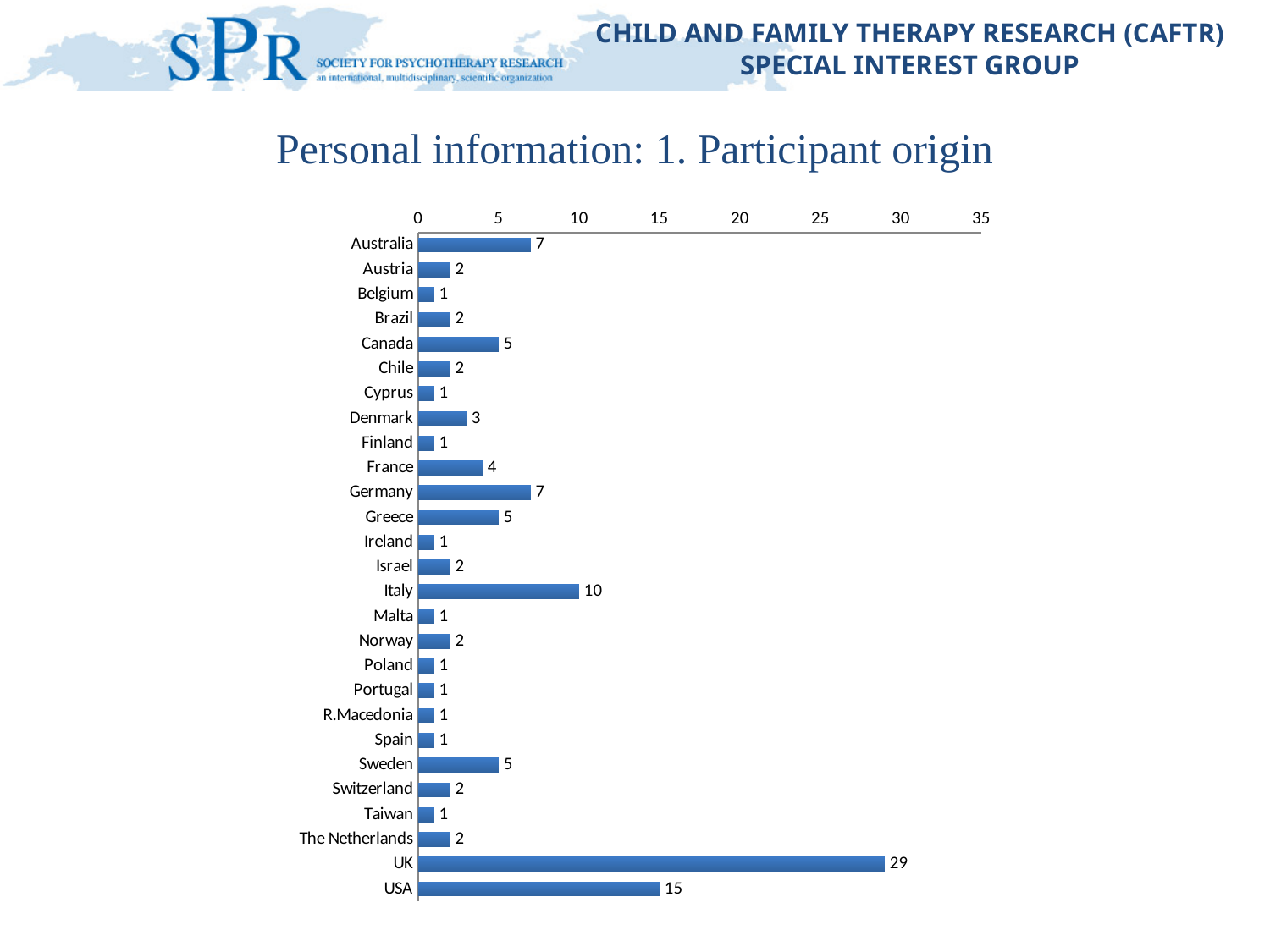
What is the difference between the values for the UK and the USA? 14 What is the difference between the values for Italy and Germany? 3 What is the value for Canada? 5 Which has a larger value, Sweden or Norway? Sweden Which country has the highest value? UK How many countries are shown in the chart? 27 Which has a larger value, Australia or France? Australia What is the value for Italy? 10 Is the value for the USA greater or less than 10? greater What is the value for the UK? 29 What is the value for Denmark? 3 What kind of chart is shown on the slide? Bar chart